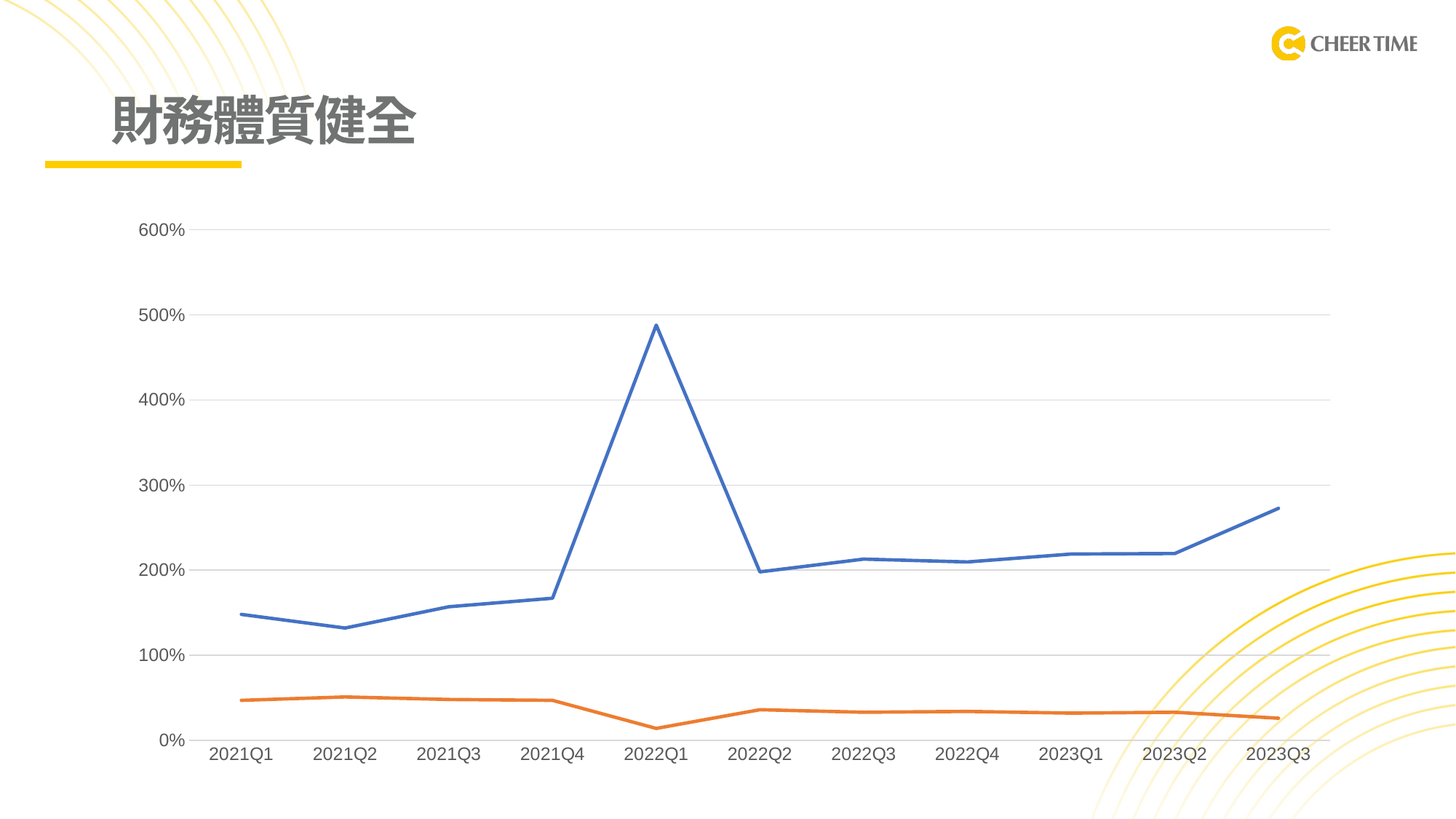
In which quarter does the blue line reach its highest value? 2022Q1 Is the value of the blue line at 2021Q2 greater or less than 200%? less How many quarters are plotted along the x axis? 11 Is the value of the orange line at 2021Q1 greater or less than 100%? less In which quarter does the blue line reach its lowest value? 2021Q2 Which line has the higher value at 2023Q3, the blue line or the orange line? the blue line Does the blue line rise or fall from 2023Q2 to 2023Q3? rise Is the value of the blue line at 2023Q3 greater or less than 200%? greater How many lines are plotted on the chart? 2 In which quarter does the orange line reach its lowest value? 2022Q1 What kind of chart is shown on the slide? line chart